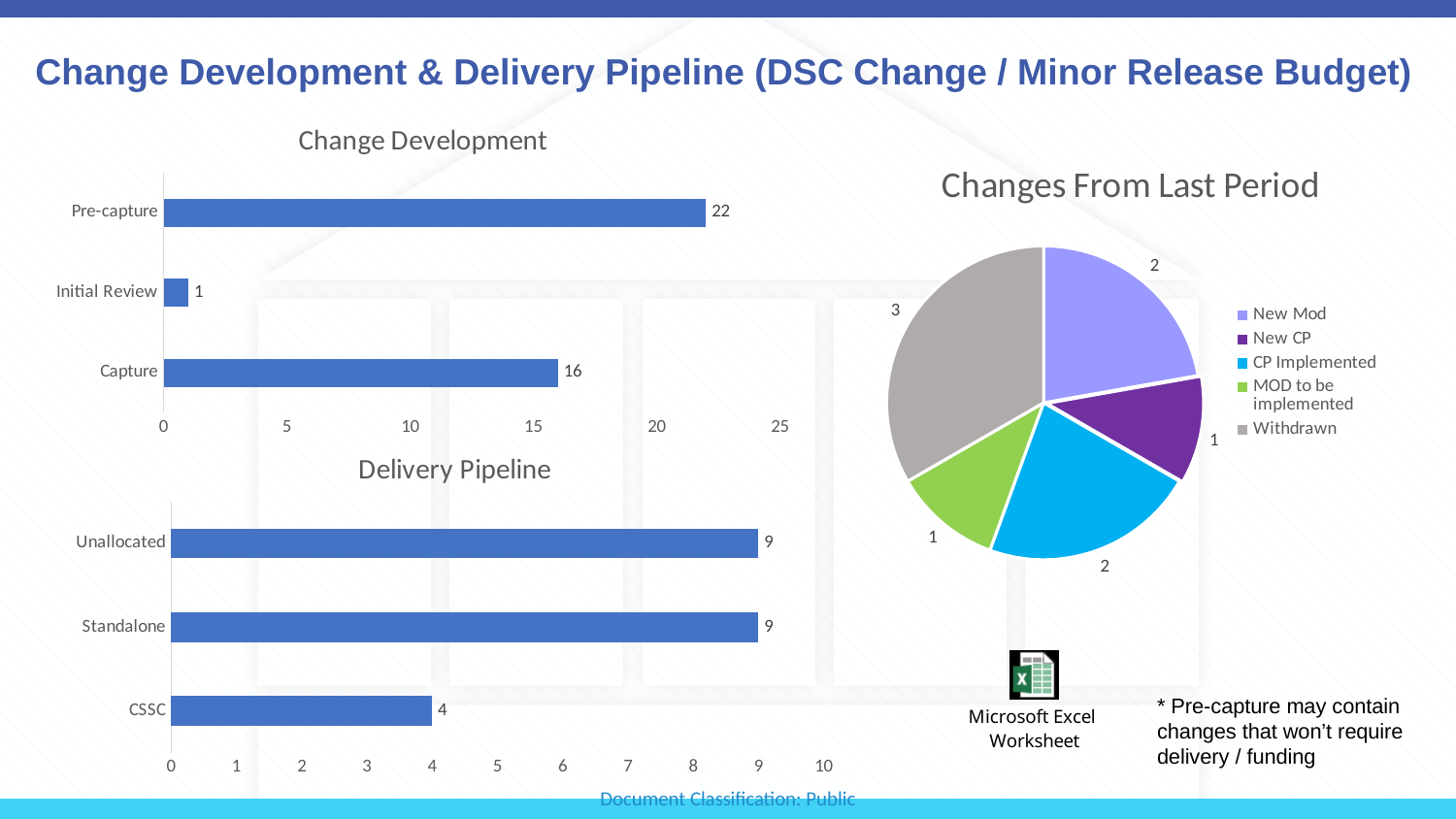
In the Changes From Last Period chart, what is the value for Withdrawn? 3 In the Delivery Pipeline chart, what is the value for CSSC? 4 In the Changes From Last Period chart, which category has the largest slice? Withdrawn In the Delivery Pipeline chart, how many categories are shown? 3 In the Change Development chart, what is the difference between Pre-capture and Capture? 6 In the Change Development chart, which category has the lowest value? Initial Review In the Change Development chart, what is the value for Capture? 16 In the Changes From Last Period chart, what is the total of all slices? 9 How many entries does the legend of the Changes From Last Period chart list? 5 What kind of chart is the Delivery Pipeline chart? bar chart In the Change Development chart, what is the value for Pre-capture? 22 In the Delivery Pipeline chart, is the value for Unallocated larger or smaller than the value for CSSC? larger